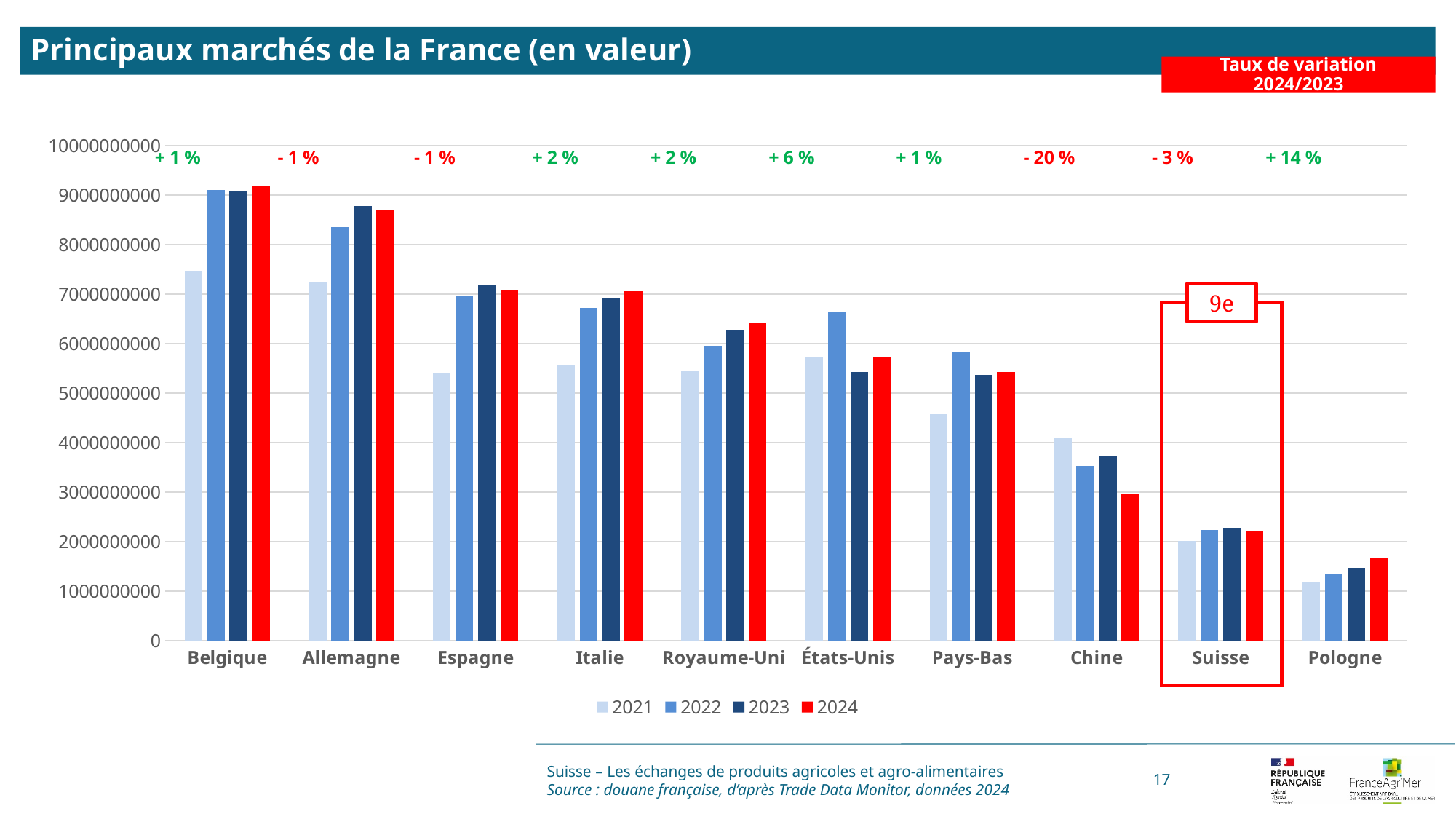
Is the 2024 value for Chine greater or less than 4000000000? less What rank label is shown in the red box above Suisse? 9e Is the 2024 value for Allemagne greater or less than 9000000000? less What is the 2024/2023 variation rate printed above Suisse? - 3 % Which country has the highest 2024 value? Belgique What kind of chart is shown on the slide? bar chart Which country has the lowest 2024 value? Pologne How many countries are shown on the x axis of the chart? 10 What is the 2024/2023 variation rate printed above Pologne? + 14 % Which has the larger 2024 value, Belgique or Allemagne? Belgique What is the 2024/2023 variation rate printed above Chine? - 20 % How many series does the legend list? 4